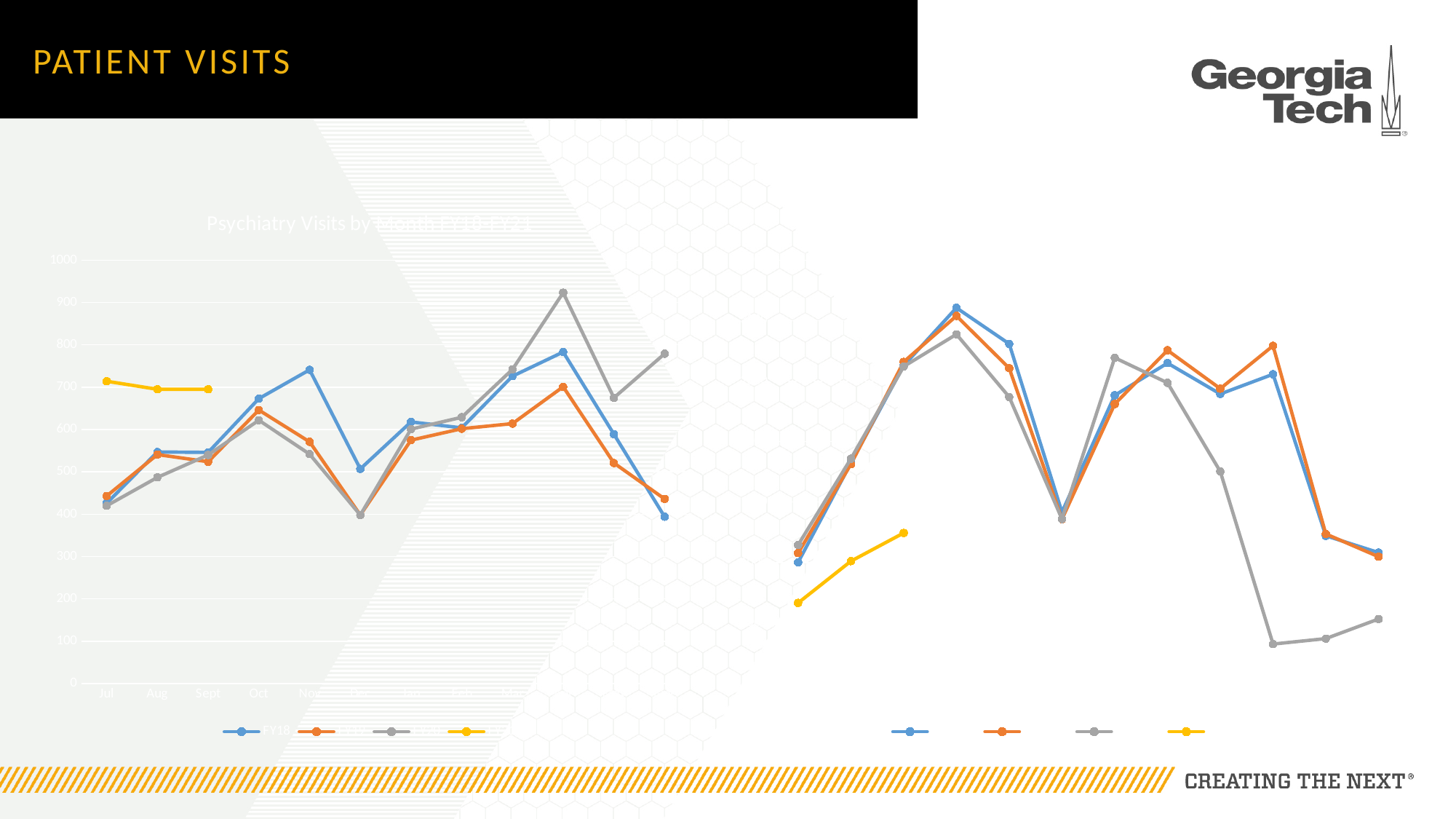
In the left chart, how many series does the legend list? 4 In the left chart, is the FY21 value for Jul greater or less than 600? greater In the left chart, is the FY18 value for Jul greater or less than 500? less In the left chart, which series is drawn in yellow? FY21 In the left chart, how many data points does the FY21 series have? 3 In the right chart, do the values of the yellow series rise or fall from left to right? rise In the left chart, is the FY20 value for Mar greater or less than 800? less What is the title of the chart on the left of the slide? Psychiatry Visits by Month FY18-FY21 What kind of chart is the chart on the right of the slide? line chart What kind of chart is the chart on the left of the slide? line chart In the right chart, how many series does the legend show? 4